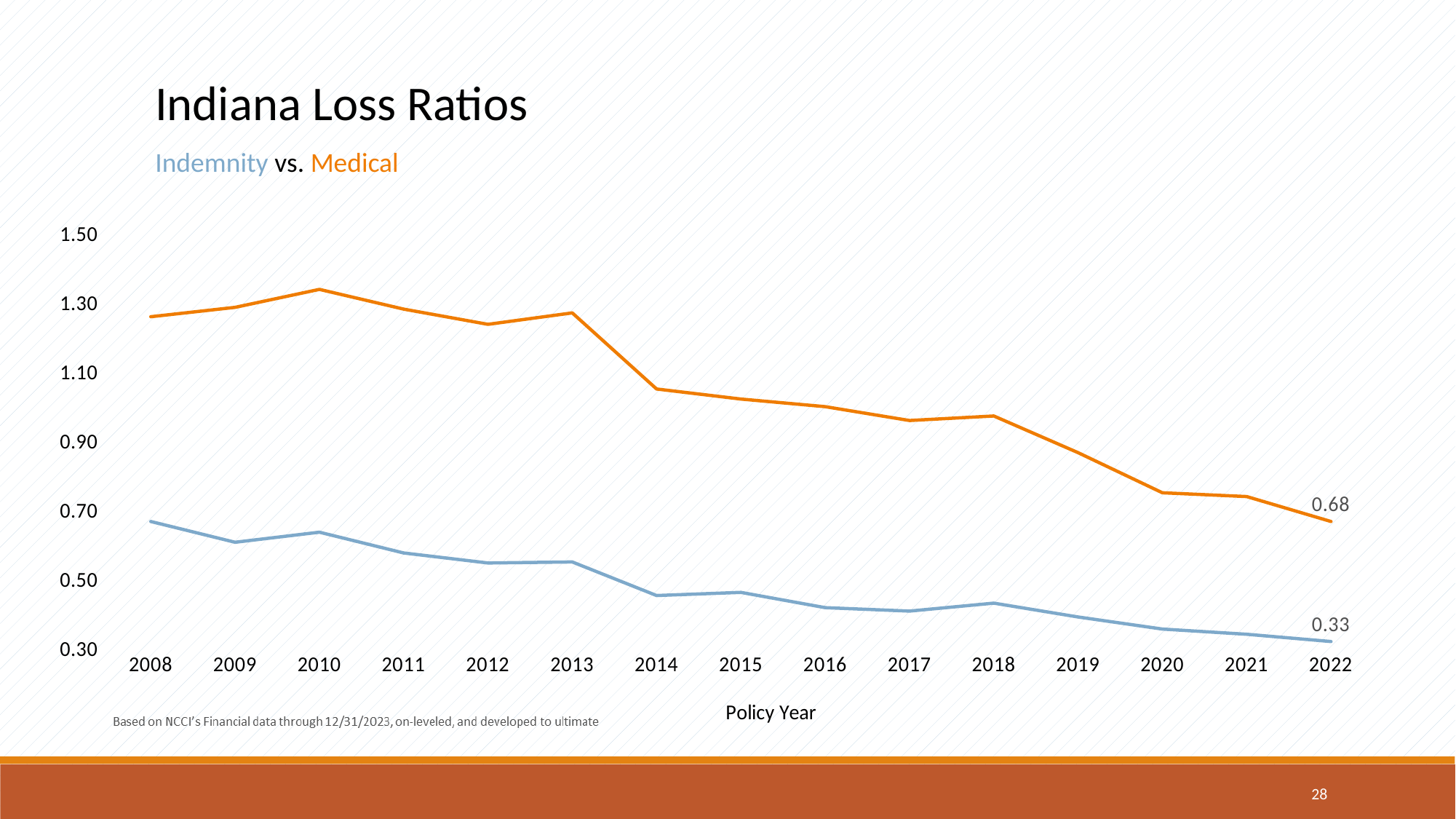
What is the Indemnity loss ratio for policy year 2022? 0.33 How many series are plotted on the chart? 2 In which policy year is the Medical loss ratio highest? 2010 In 2022, which is larger, the Medical or the Indemnity loss ratio? Medical In which policy year is the Indemnity loss ratio lowest? 2022 How many policy years are shown on the x axis? 15 What is the difference between the Medical and Indemnity loss ratios in 2022? 0.35 What kind of chart is shown on the slide? Line chart Is the Medical loss ratio for 2020 greater or less than 0.90? less In which policy year is the Medical loss ratio lowest? 2022 Is the Indemnity loss ratio for 2011 greater or less than 0.50? greater What is the Medical loss ratio for policy year 2022? 0.68